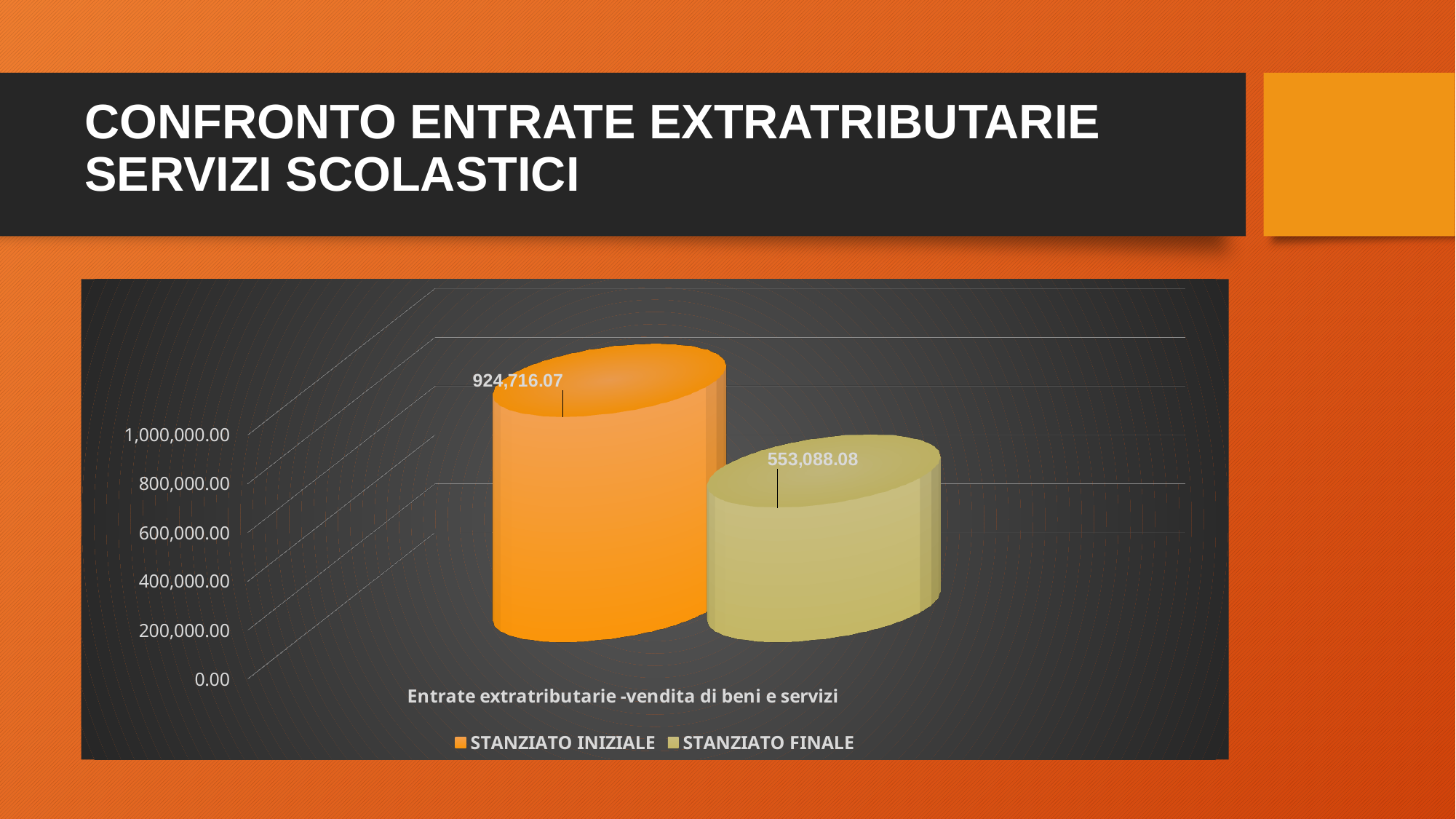
What is the category label shown on the x axis? Entrate extratributarie -vendita di beni e servizi What is the difference between STANZIATO INIZIALE and STANZIATO FINALE? 371,627.99 Which series has the higher value, STANZIATO INIZIALE or STANZIATO FINALE? STANZIATO INIZIALE What colour is the STANZIATO INIZIALE bar? orange What is the value for STANZIATO FINALE? 553,088.08 How many categories are shown on the x axis? 1 Is the value for STANZIATO INIZIALE greater or less than 800,000.00? greater What kind of chart is shown on the slide? bar chart Is the value for STANZIATO FINALE greater or less than 600,000.00? less How many series does the legend list? 2 What is the value for STANZIATO INIZIALE? 924,716.07 Which series has the lowest value? STANZIATO FINALE